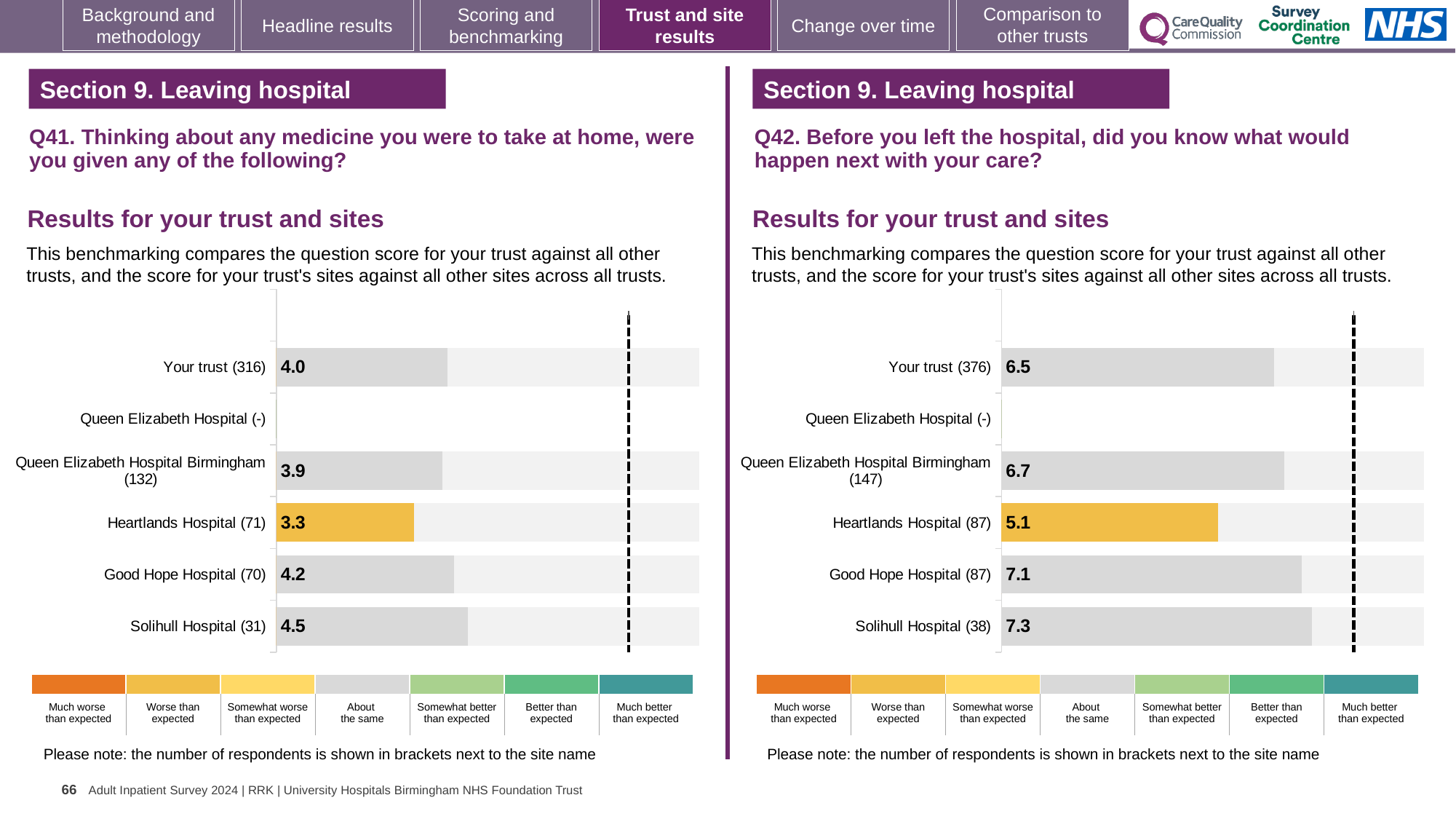
In the Q42 chart on the right, what is the score for Queen Elizabeth Hospital Birmingham (147)? 6.7 In the Q42 chart on the right, which site has the lowest score? Heartlands Hospital (87) In the Q42 chart on the right, what is the score for Good Hope Hospital (87)? 7.1 In the Q41 chart on the left, what is the score for Your trust (316)? 4.0 In the Q41 chart on the left, which site has the lowest score? Heartlands Hospital (71) In the Q42 chart on the right, what is the difference between the scores for Solihull Hospital (38) and Your trust (376)? 0.8 In the Q41 chart on the left, what is the score for Heartlands Hospital (71)? 3.3 What type of chart is used for the Q41 results on the left? Bar chart In the Q42 chart on the right, how many bars have a printed score? 5 In the Q42 chart on the right, which is larger: the score for Solihull Hospital (38) or Your trust (376)? Solihull Hospital (38) In the Q41 chart on the left, which site has the highest score? Solihull Hospital (31) In the Q41 chart on the left, what is the difference between the scores for Solihull Hospital (31) and Heartlands Hospital (71)? 1.2